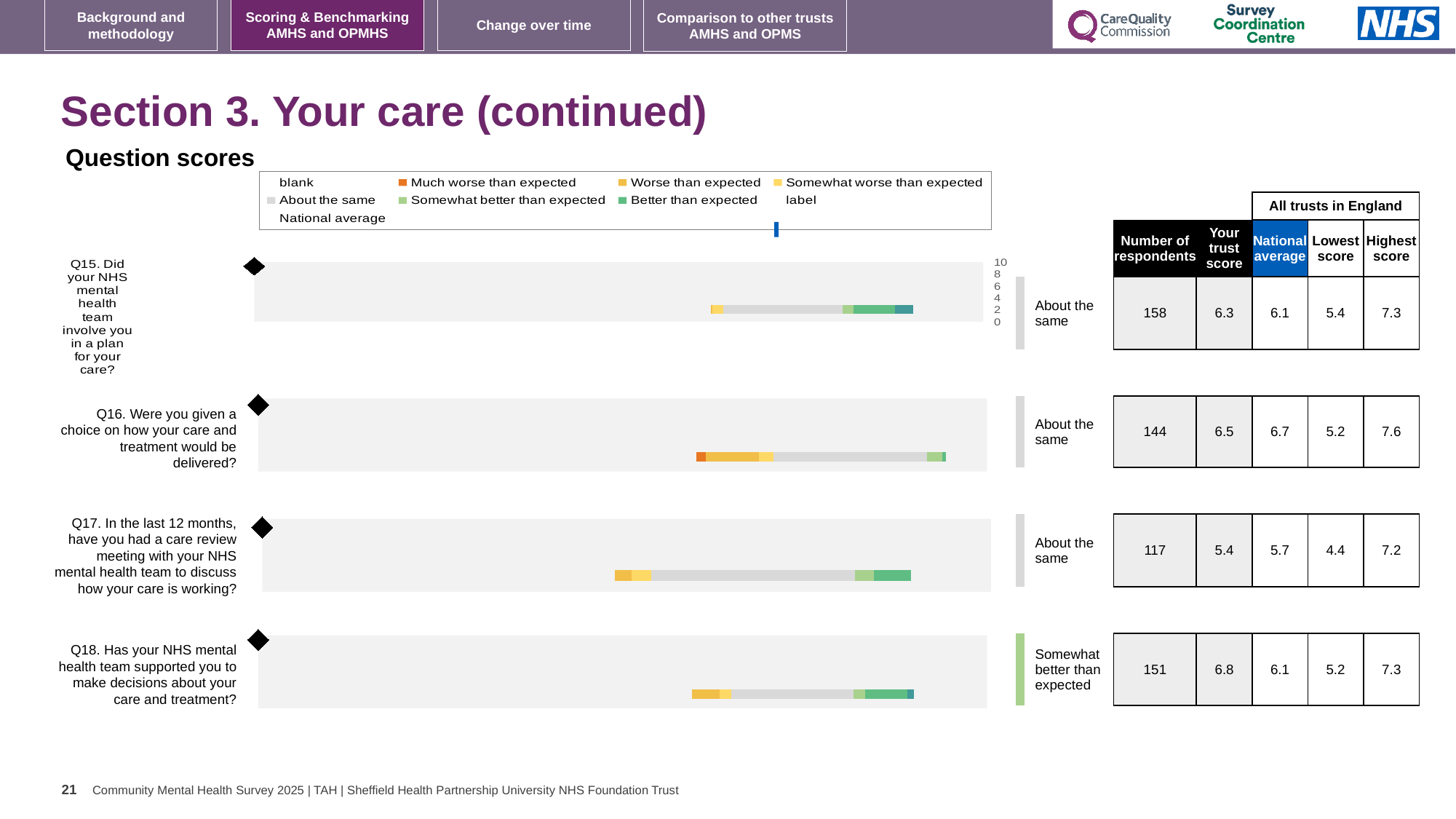
In the table, what is the difference between the trust score and the national average for Q18? 0.7 What is the benchmark label shown next to the bar for Q16? About the same What kind of chart is used to show the question scores on this slide? bar chart In the table, what is the 'Your trust score' for Q15? 6.3 In the table, which question has the highest 'Your trust score'? Q18 In the table, which question has the lowest number of respondents? Q17 In the table for Q16, which is larger: the trust score or the national average? National average In the table, what is the number of respondents for Q17? 117 In the table, what is the highest score among all trusts in England for Q16? 7.6 How many survey questions (Q15 to Q18) have a bar chart on this slide? 4 What is the benchmark label shown next to the bar for Q18? Somewhat better than expected Which question's bar contains a 'Much worse than expected' (orange) segment? Q16